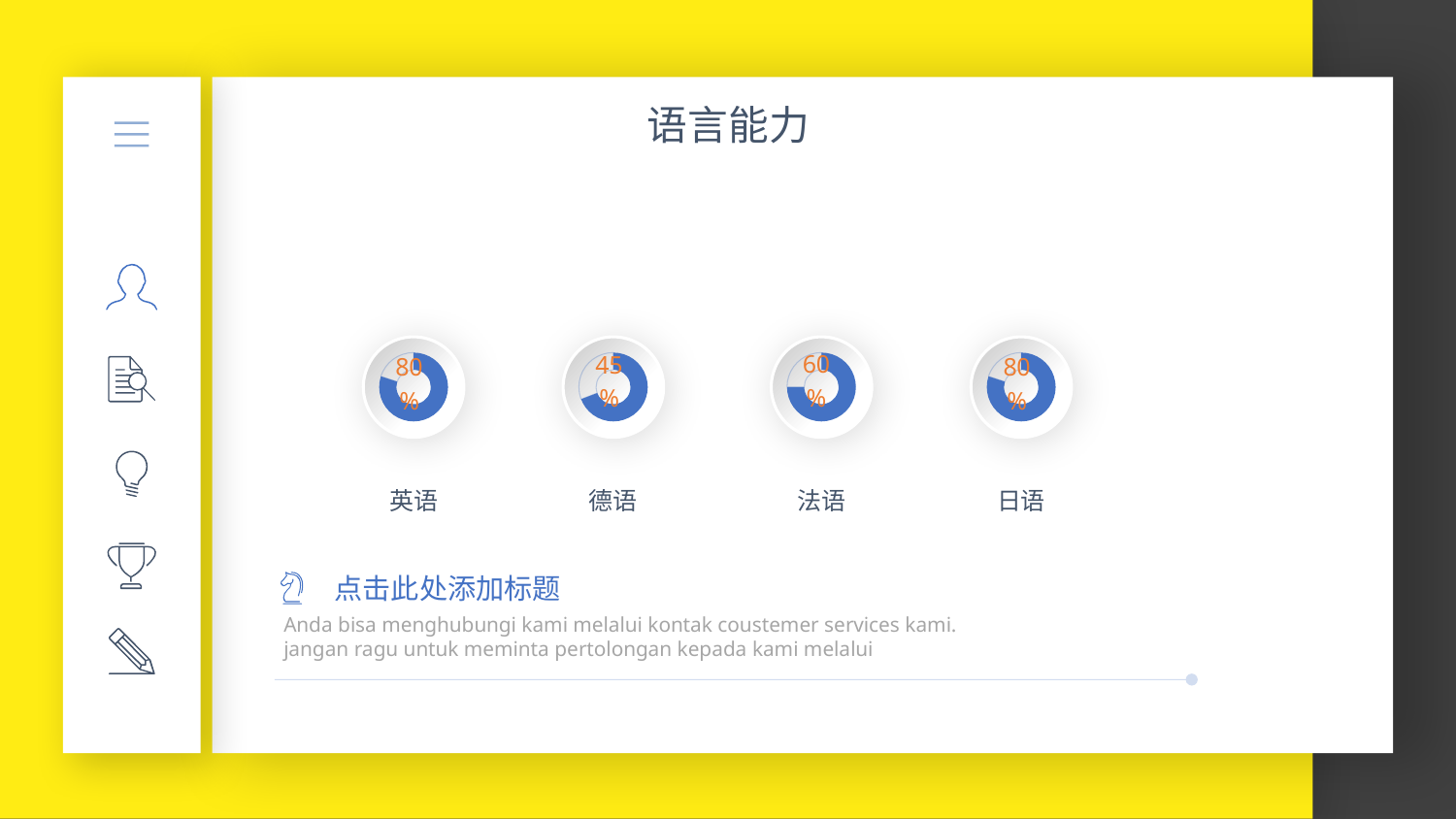
What is the difference between the percentages for 法语 and 德语? 15% What is the difference between the percentages for 英语 and 法语? 20% Which two languages share the same percentage? 英语 and 日语 Which language has the lowest percentage on the slide? 德语 What percentage is shown for 法语 (French)? 60% What percentage is shown for 德语 (German)? 45% How many language charts are shown on the slide? 4 What kind of chart is used to show each language's percentage? Doughnut (pie) chart What percentage is shown for 日语 (Japanese)? 80% Which is larger, the percentage for 法语 or for 德语? 法语 What percentage is shown for 英语 (English)? 80% What is the title of the slide containing the charts? 语言能力